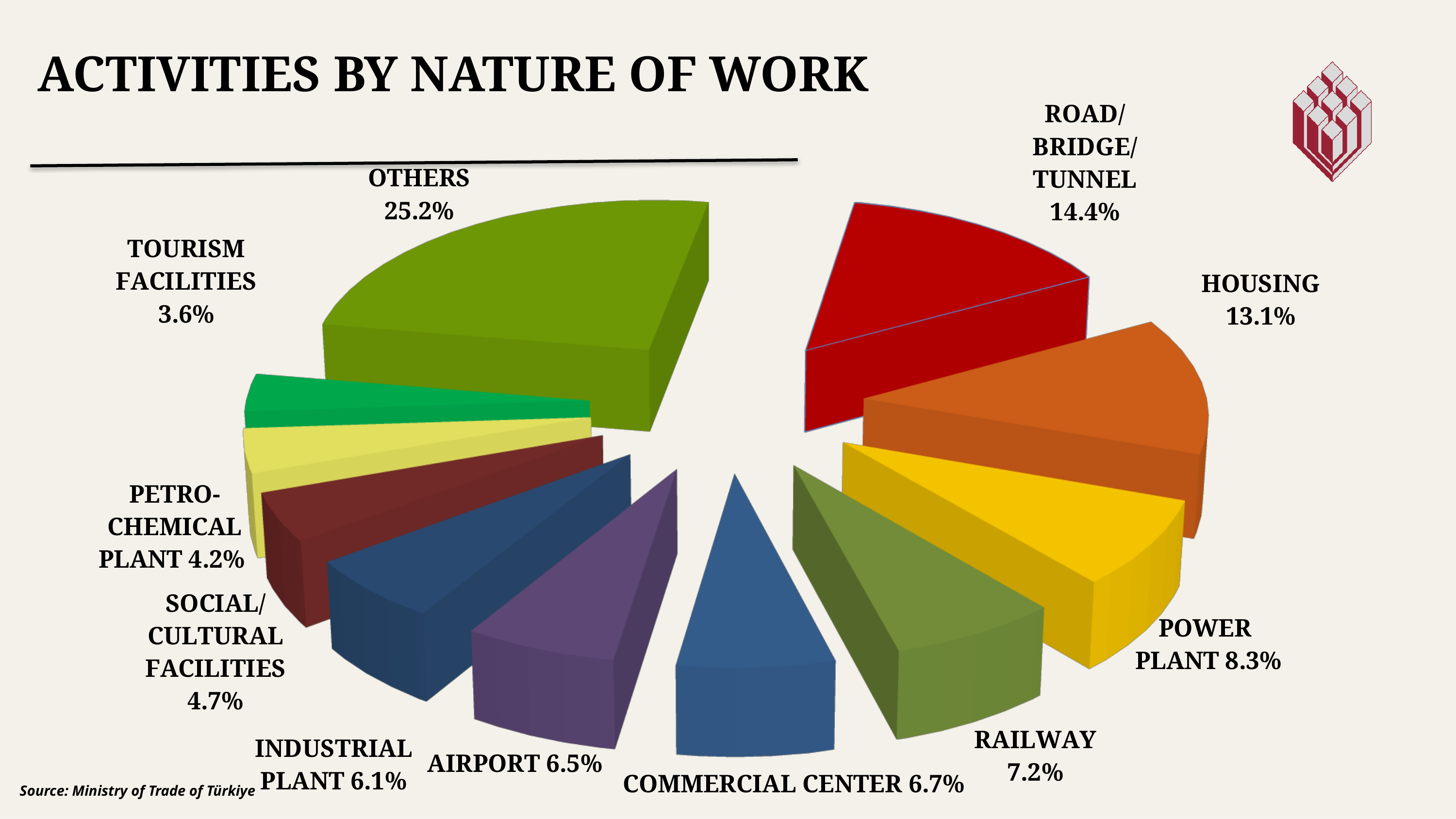
What is the difference between the shares for Others and Tourism Facilities? 21.6% What is the share for Railway? 7.2% What is the share for Housing? 13.1% Which category has the largest share? Others What is the title of the chart? ACTIVITIES BY NATURE OF WORK What kind of chart is shown on the slide? Pie chart What is the difference between the shares for Road/Bridge/Tunnel and Housing? 1.3% How many categories are shown in the pie chart? 11 Which category has the smallest share? Tourism Facilities What is the share for Petro-Chemical Plant? 4.2% Which has a larger share, Power Plant or Railway? Power Plant What is the share for Road/Bridge/Tunnel? 14.4%